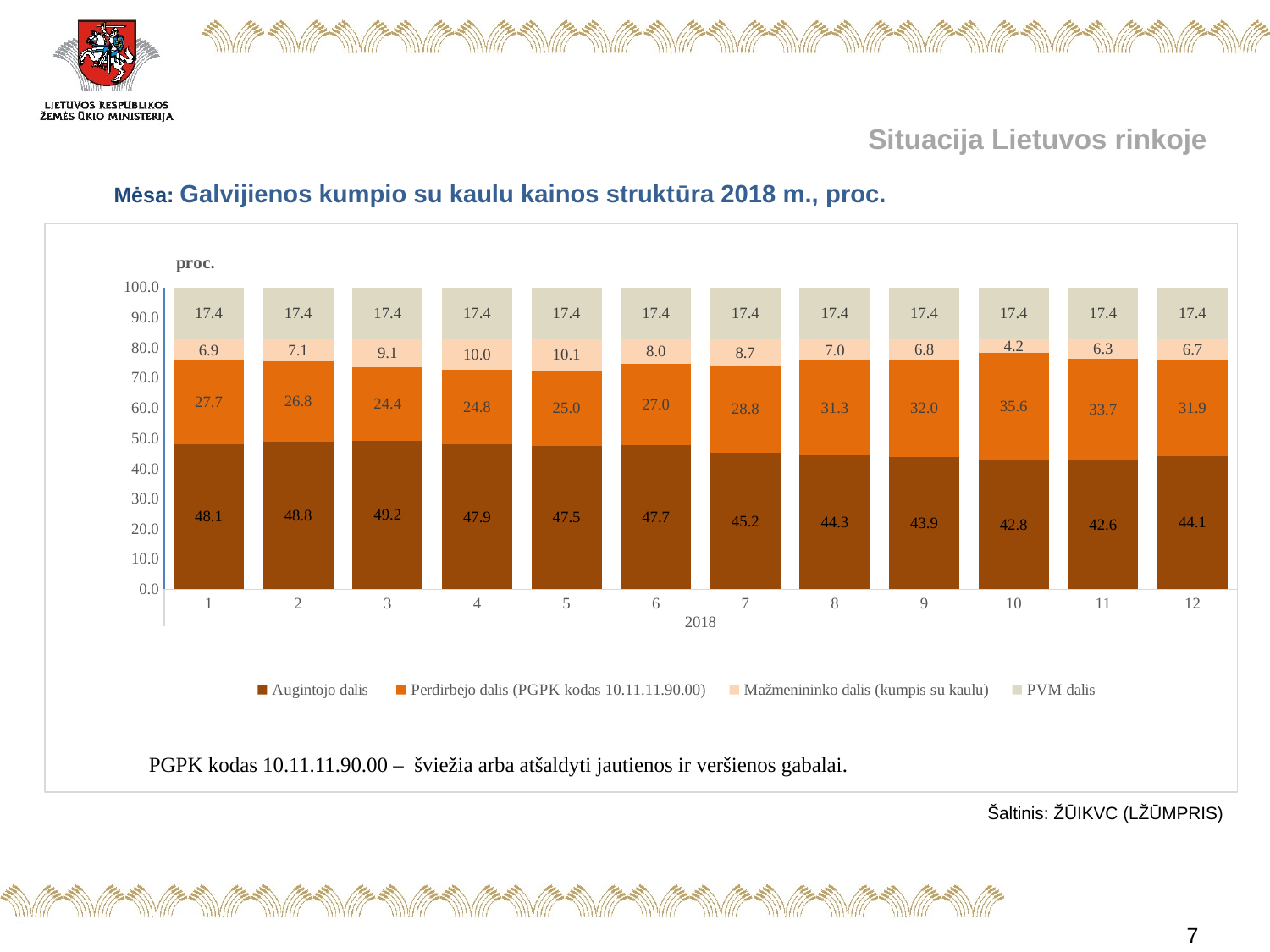
What is the value of PVM dalis for month 7? 17.4 In which month is Mažmenininko dalis (kumpis su kaulu) lowest? 10 How many series does the legend list? 4 Which is larger: Augintojo dalis in month 2 or in month 9? Month 2 What kind of chart is shown on the slide? Stacked bar chart In which month is Augintojo dalis highest? 3 What is the difference between Perdirbėjo dalis in month 10 and in month 1? 7.9 What is the value of Perdirbėjo dalis (PGPK kodas 10.11.11.90.00) for month 10? 35.6 How many months are shown on the x axis? 12 What is the value of Augintojo dalis for month 1 of 2018? 48.1 What is the value of Mažmenininko dalis (kumpis su kaulu) for month 5? 10.1 In which month is Augintojo dalis lowest? 11